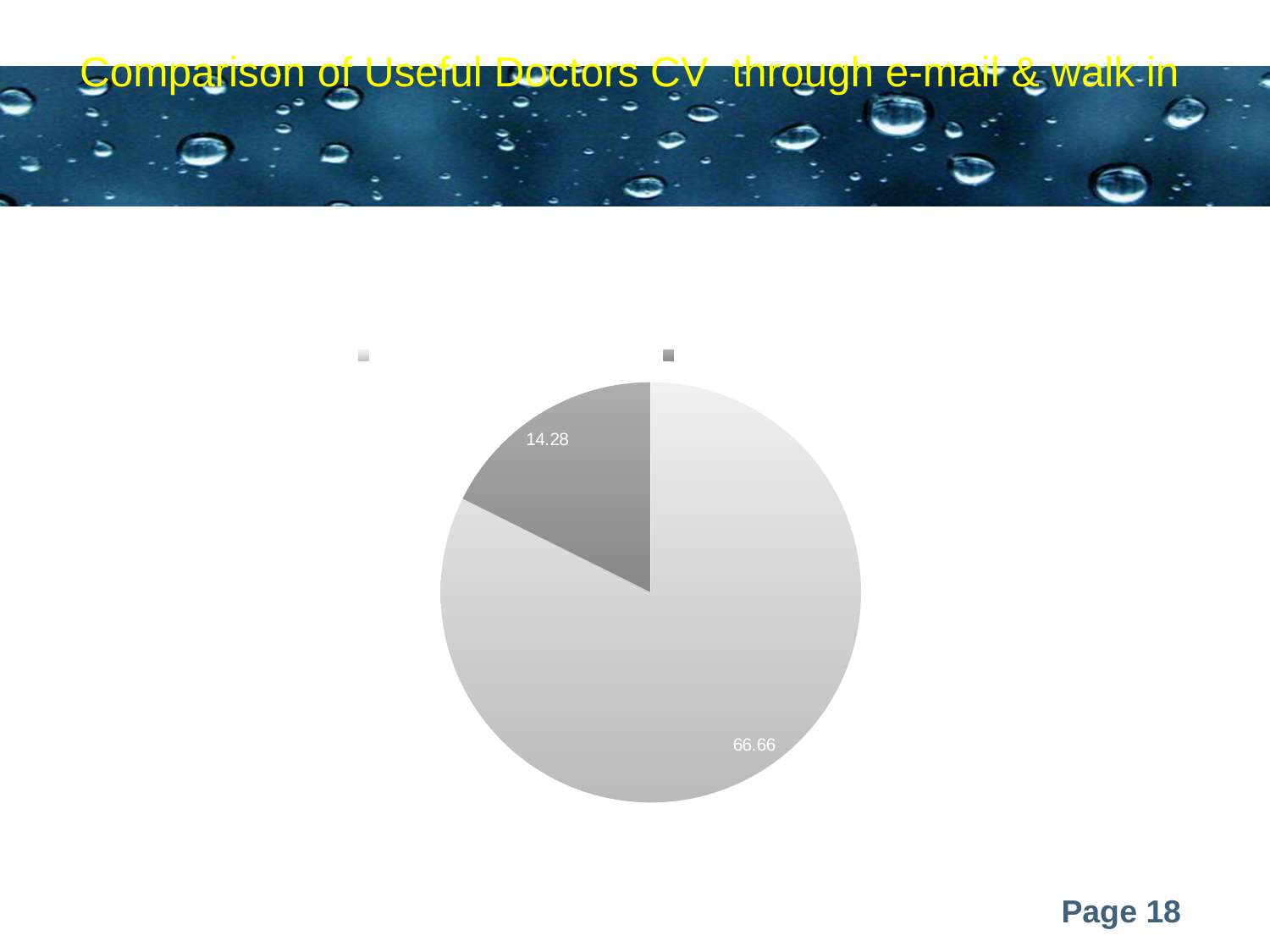
Is the value of the darker grey slice greater or less than 20? less What is the title of the slide containing the pie chart? Comparison of Useful Doctors CV through e-mail & walk in What is the value labelled on the lighter grey slice of the pie chart? 66.66 Is the value of the lighter grey slice greater or less than 50? greater How many slices does the pie chart have? 2 How many legend markers are shown above the pie chart? 2 What kind of chart is shown on the slide? pie chart What is the difference between the two slice values shown on the pie chart? 52.38 What is the value shown on the smallest slice of the pie chart? 14.28 What is the value labelled on the darker grey slice of the pie chart? 14.28 What is the value shown on the largest slice of the pie chart? 66.66 Which slice is larger, the darker grey slice or the lighter grey slice? the lighter grey slice